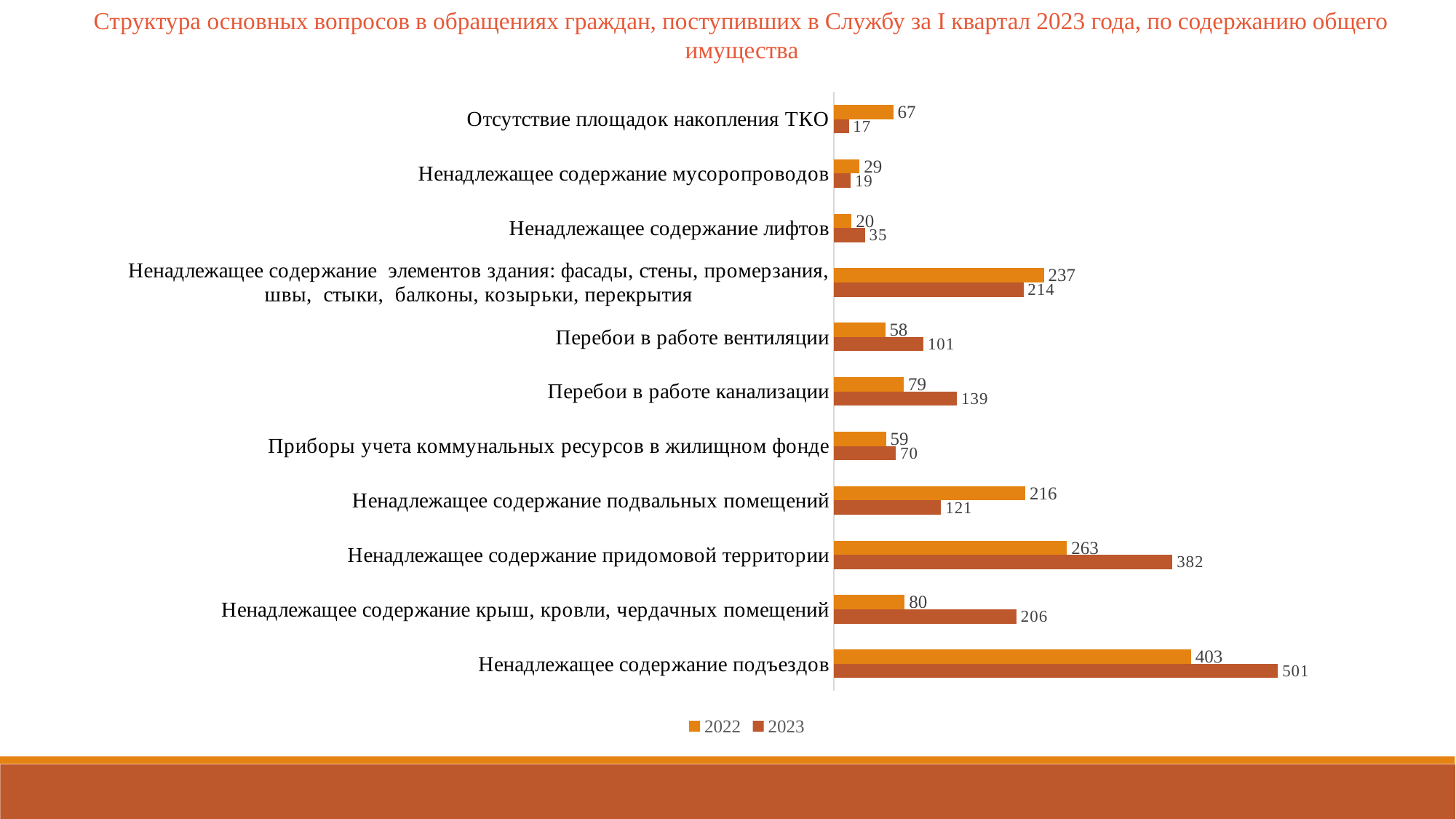
For «Ненадлежащее содержание элементов здания», which year has the larger value, 2022 or 2023? 2022 How many series does the legend list? 2 What is the 2022 value for «Ненадлежащее содержание придомовой территории»? 263 What is the difference between the 2023 and 2022 values for «Ненадлежащее содержание крыш, кровли, чердачных помещений»? 126 Which category has the lowest 2022 value? Ненадлежащее содержание лифтов What is the 2023 value for «Перебои в работе вентиляции»? 101 What is the 2023 value for «Ненадлежащее содержание подъездов»? 501 What type of chart is shown on the slide? Bar chart Which category has the highest 2023 value? Ненадлежащее содержание подъездов Which category has the lowest 2023 value? Отсутствие площадок накопления ТКО What is the difference between the 2022 and 2023 values for «Ненадлежащее содержание подвальных помещений»? 95 How many categories are shown on the chart? 11